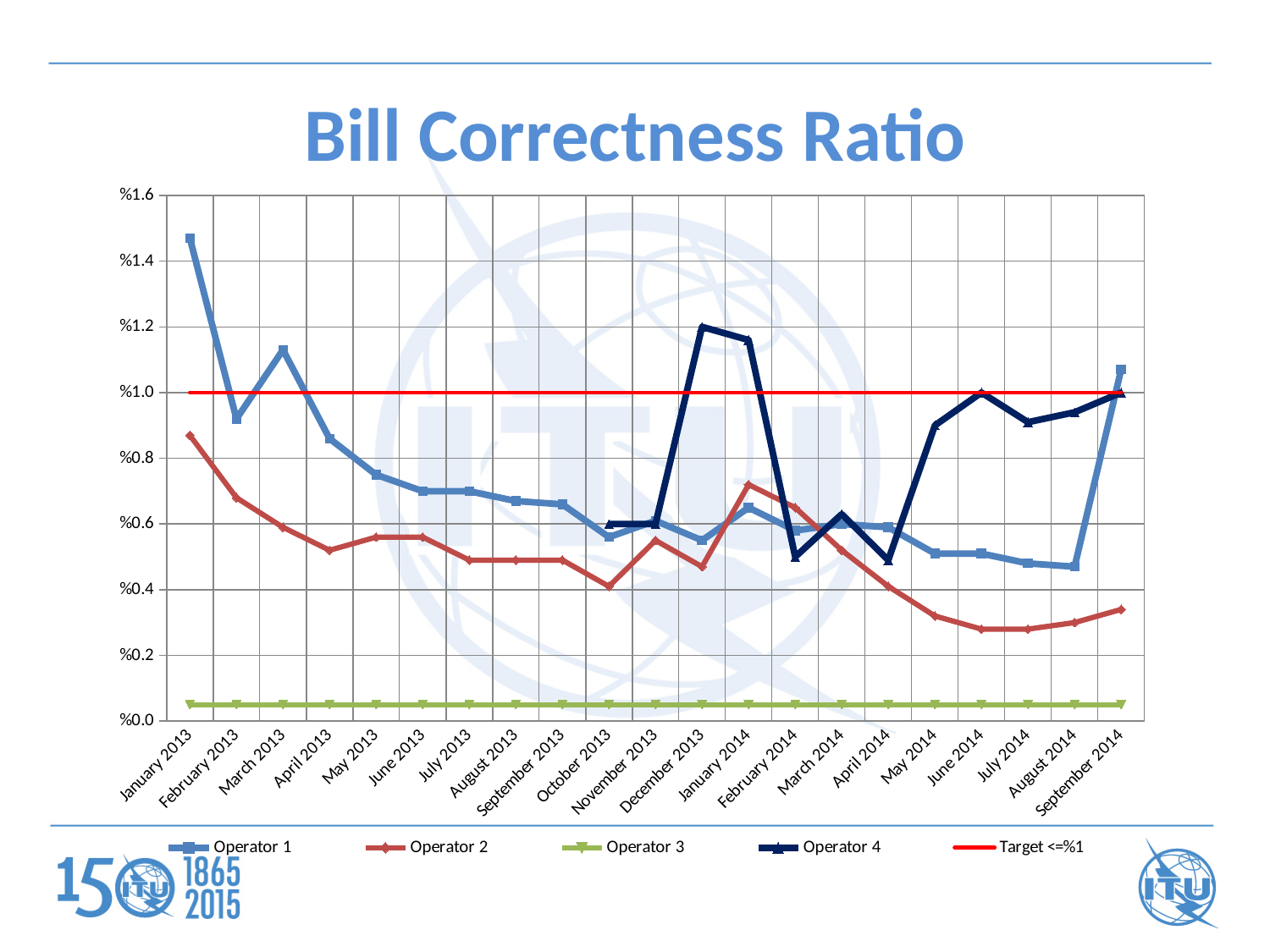
In which month does Operator 1 reach its highest value? January 2013 What kind of chart is shown on the slide? Line chart How many series does the legend list? 5 Which is larger in December 2013, the value for Operator 4 or the value for Operator 1? Operator 4 Does the value for Operator 2 rise or fall from January 2013 to April 2013? Fall Is the value for Operator 3 in January 2013 greater or less than %0.2? less Is the value for Operator 4 in December 2013 greater or less than %1.0? greater What is the title of the chart? Bill Correctness Ratio How many months are shown along the x axis? 21 Which is larger in January 2013, the value for Operator 1 or the value for Operator 2? Operator 1 Is the value for Operator 2 in June 2014 greater or less than %0.4? less